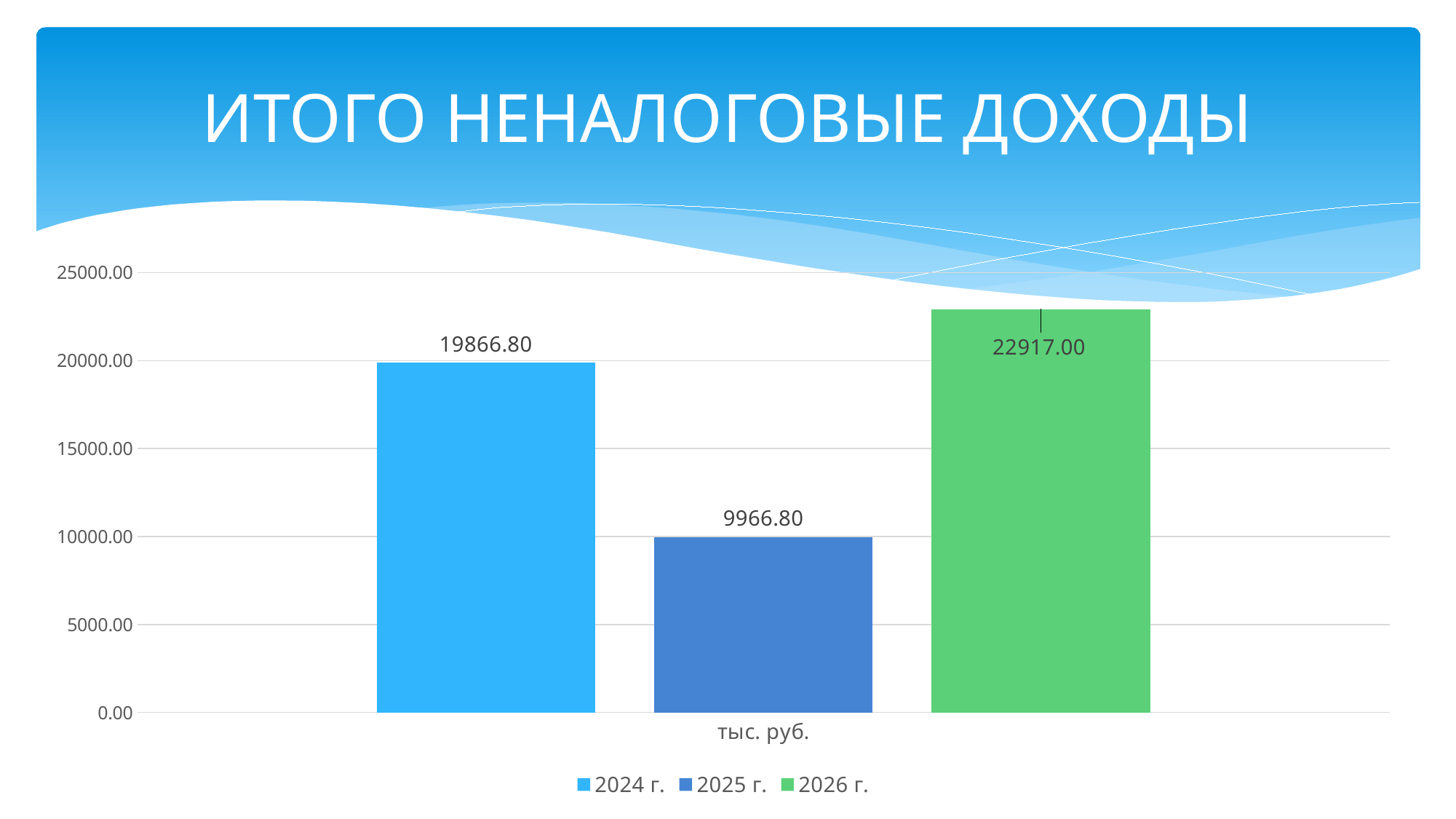
Which year has the highest value? 2026 г. Is the value for 2026 г. greater or less than 20000.00? greater What is the difference between the values for 2026 г. and 2024 г.? 3050.20 Which year has the lowest value? 2025 г. What is the title of the slide? ИТОГО НЕНАЛОГОВЫЕ ДОХОДЫ What is the value for 2024 г.? 19866.80 What is the value for 2025 г.? 9966.80 How many series does the legend list? 3 What is the value for 2026 г.? 22917.00 Which is larger, the value for 2024 г. or the value for 2025 г.? 2024 г. What kind of chart is shown on the slide? bar chart What is the difference between the values for 2024 г. and 2025 г.? 9900.00